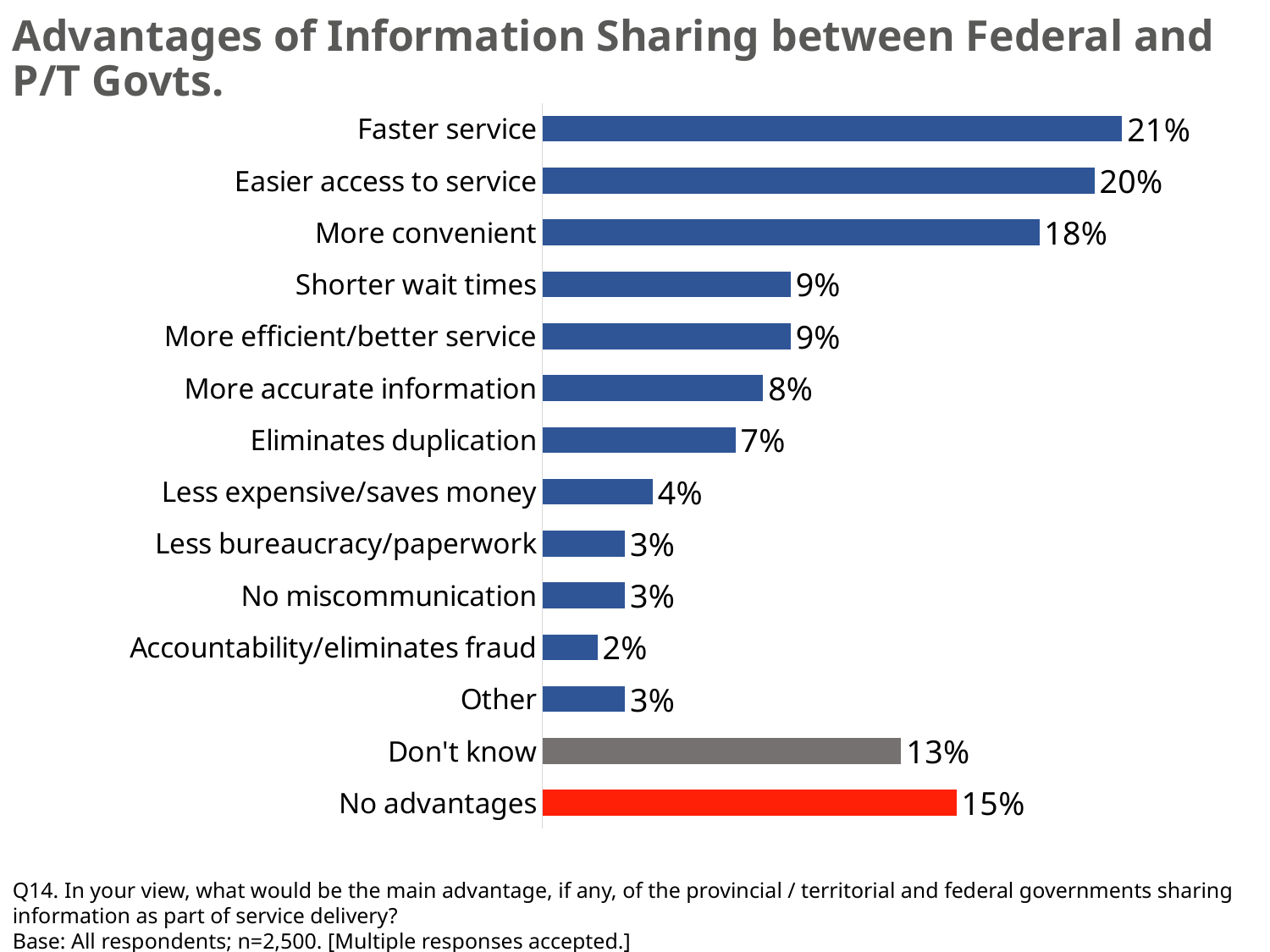
What is the difference between the values for "Faster service" and "More convenient"? 3% What is the difference between "No advantages" and "Don't know"? 2% Which category's bar is coloured red? No advantages Which category has the lowest value on the chart? Accountability/eliminates fraud How many categories are shown on the chart? 14 Which category has the highest value on the chart? Faster service Which is larger, the value for "Easier access to service" or the value for "Shorter wait times"? Easier access to service What type of chart is shown on the slide? Bar chart What is the value for "Eliminates duplication"? 7% What percentage is shown for "Don't know"? 13% What is the value shown for "No advantages"? 15% What percentage of respondents cited "Faster service" as an advantage? 21%